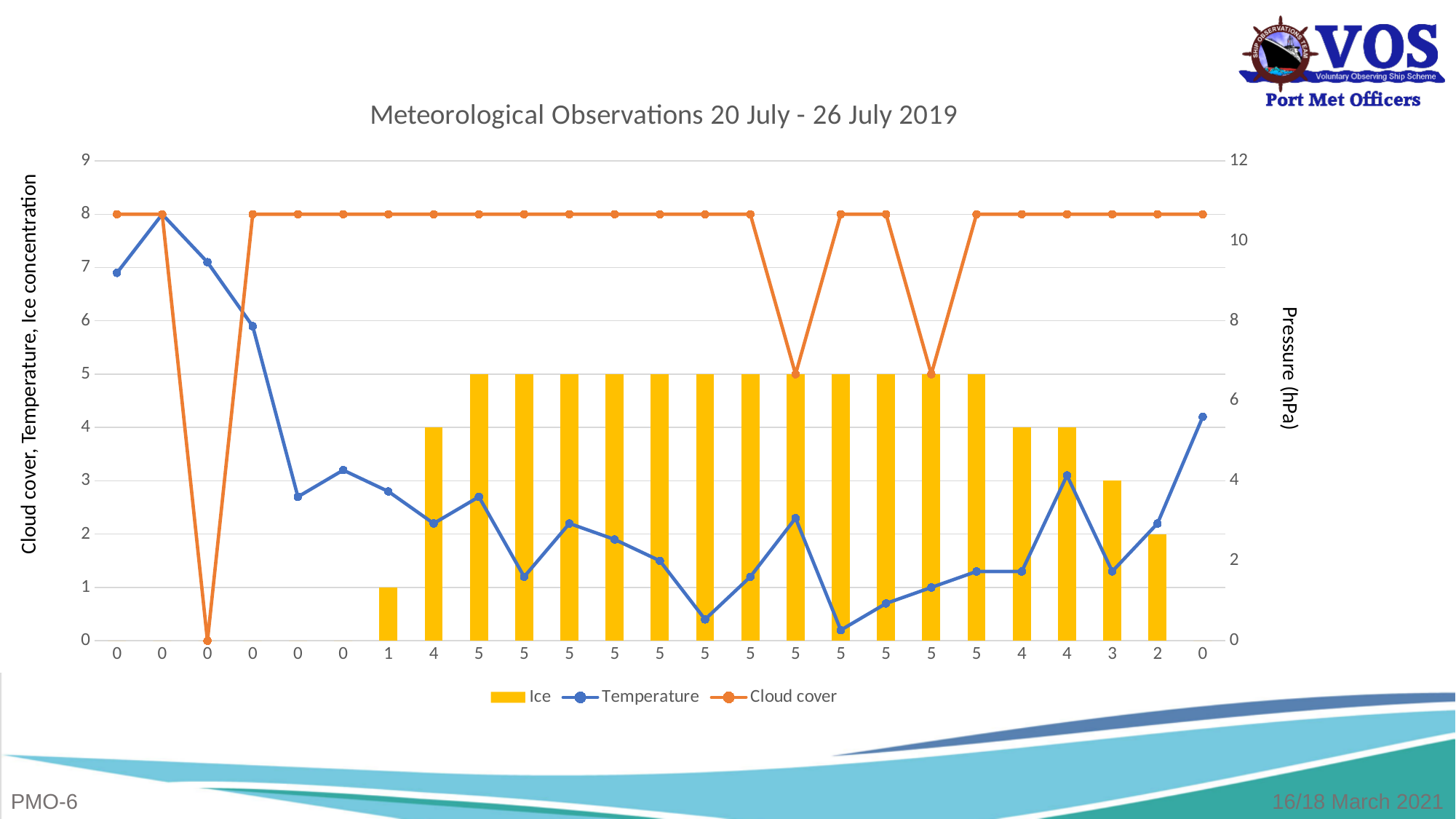
What is the highest value reached by the Ice bars? 5 What is the label of the right-hand vertical axis? Pressure (hPa) What kind of chart is this? Combined bar and line chart Is the first Temperature value greater or less than 6? greater What is the highest value of the Cloud cover series? 8 How many series does the legend list? 3 How many data points are plotted along the x axis? 25 What is the lowest value of the Cloud cover series? 0 How many Ice bars have a value of 5? 12 What is the highest value of the Temperature series? 8 At the last x-axis point, which is larger: Cloud cover or Temperature? Cloud cover What is the title of the chart? Meteorological Observations 20 July - 26 July 2019